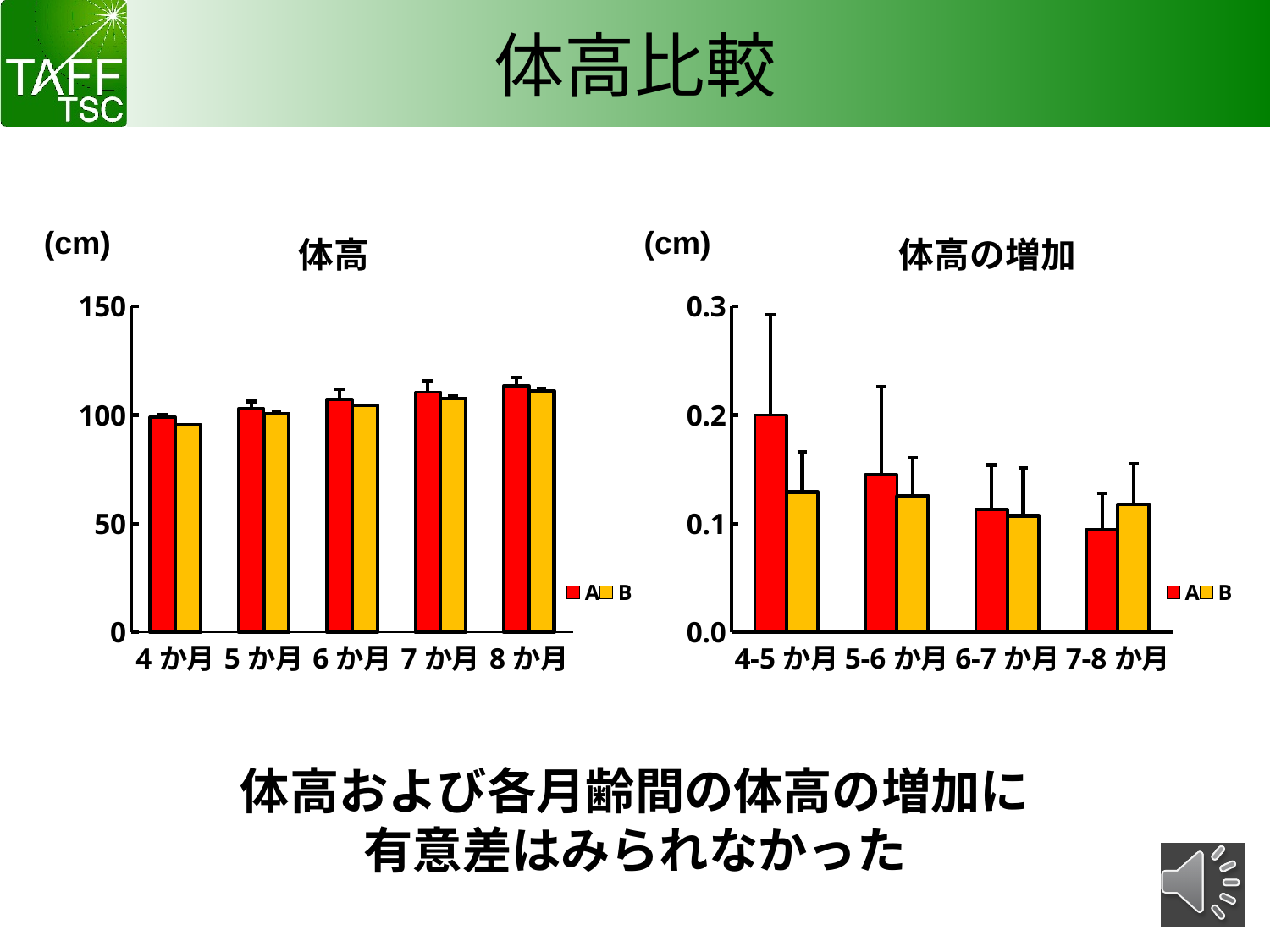
How many series does the legend of the 体高 chart list? 2 In the 体高の増加 chart, which is larger at 4-5 か月, A or B? A What kind of chart is the 体高 chart on the left? bar chart How many age categories are shown on the x axis of the 体高 chart? 5 In the 体高 chart, is the value for B at 4 か月 greater or less than 50? greater What unit is shown above the y axis of both charts? (cm) In the 体高の増加 chart, which category has the highest value for A? 4-5 か月 How many categories are shown on the x axis of the 体高の増加 chart? 4 In the 体高 chart, is the value for A at 8 か月 greater or less than 100? greater In the 体高の増加 chart, is the value for A at 5-6 か月 greater or less than 0.1? greater In the 体高 chart, do the values for A rise or fall from 4 か月 to 8 か月? rise In the 体高の増加 chart, do the values for A rise or fall from 4-5 か月 to 7-8 か月? fall